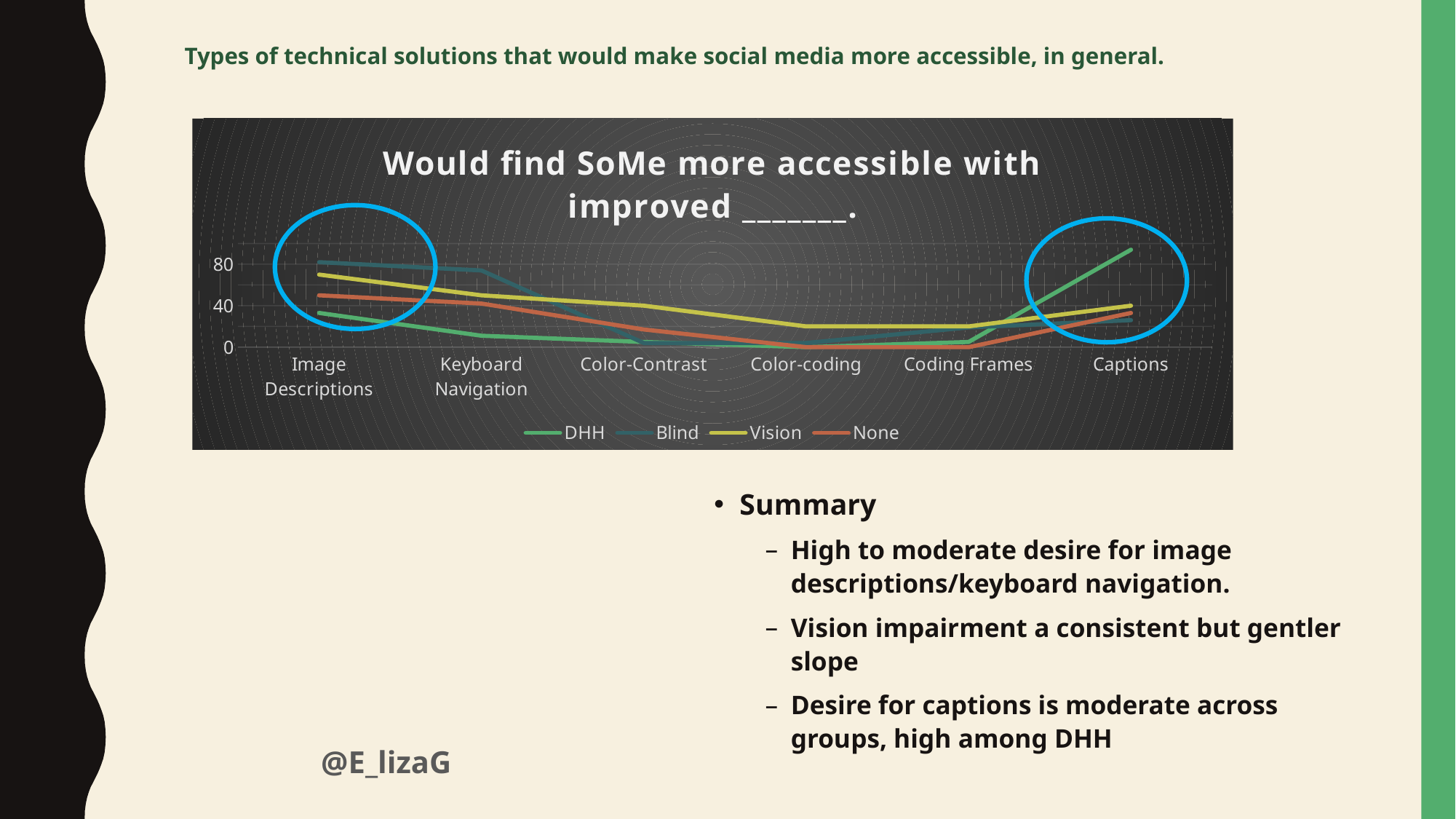
How many categories are shown along the x axis of the chart? 6 Is the DHH value for Image Descriptions greater or less than 40? less Is the Blind value for Keyboard Navigation greater or less than 40? greater Is the DHH value for Captions greater or less than 80? greater How many series does the chart legend list? 4 What kind of chart is shown on the slide? line chart Which series has the highest value at Image Descriptions? Blind Which series has the highest value at Captions? DHH Does the Blind series rise or fall from Keyboard Navigation to Color-coding? fall At Keyboard Navigation, which series has the larger value, Vision or DHH? Vision For the DHH series, which category has the highest value? Captions